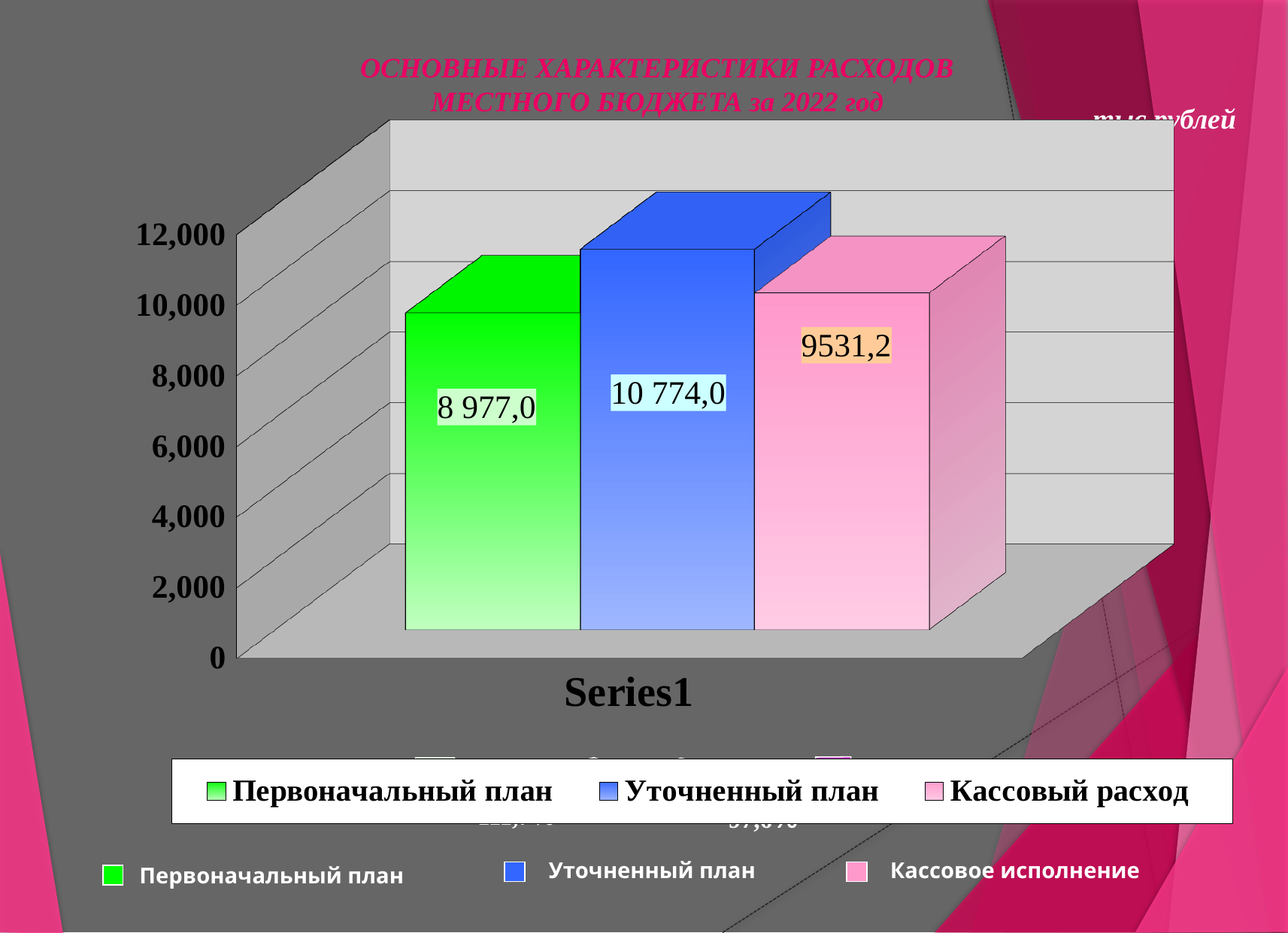
What is the value for Кассовый расход? 9531,2 What is the difference between Уточненный план and Первоначальный план? 1 797,0 What is the difference between Уточненный план and Кассовый расход? 1 242,8 Which series has the lowest value? Первоначальный план What is the value for Уточненный план? 10 774,0 What unit is stated for the values in the chart? тыс.рублей What is the value for Первоначальный план? 8 977,0 Is the value for Уточненный план greater or less than 10,000? greater How many series does the legend list? 3 What kind of chart is shown on the slide? bar chart Which series has the highest value? Уточненный план Which is larger, Кассовый расход or Первоначальный план? Кассовый расход